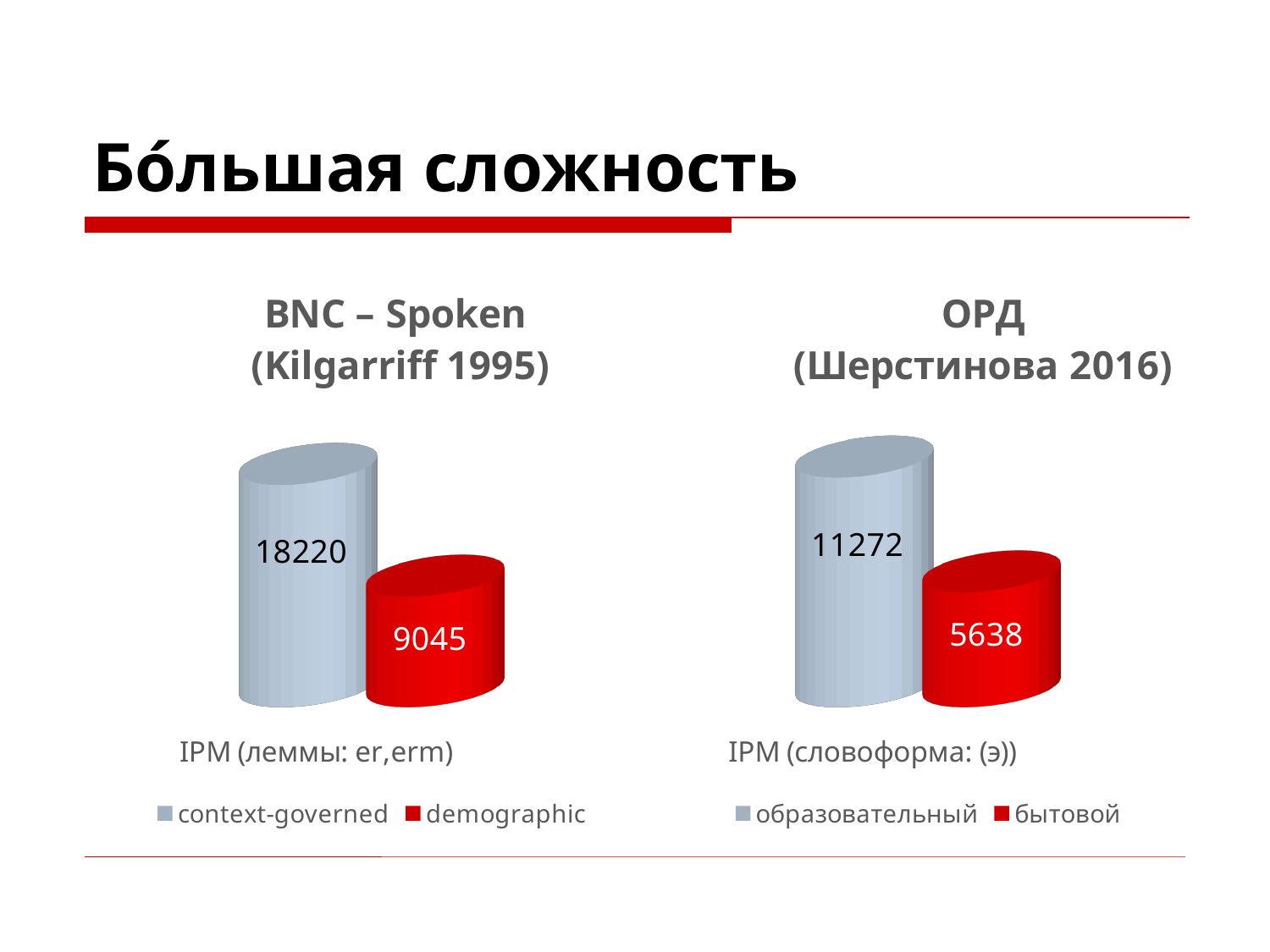
What is the category label shown under the bars of the ОРД (Шерстинова 2016) chart? IPM (словоформа: (э)) In the BNC – Spoken (Kilgarriff 1995) chart, what is the difference between the context-governed and demographic values? 9175 In the ОРД (Шерстинова 2016) chart, what is the difference between the образовательный and бытовой values? 5634 In the ОРД (Шерстинова 2016) chart, which series has the lower value? бытовой In the ОРД (Шерстинова 2016) chart, what is the value for образовательный? 11272 In the BNC – Spoken (Kilgarriff 1995) chart, what is the value for demographic? 9045 In the BNC – Spoken (Kilgarriff 1995) chart, what is the value for context-governed? 18220 What kind of chart is the BNC – Spoken (Kilgarriff 1995) chart? bar chart How many series does the legend of the ОРД (Шерстинова 2016) chart list? 2 In the BNC – Spoken (Kilgarriff 1995) chart, which series has the higher value? context-governed Is the context-governed value in the BNC – Spoken chart larger or smaller than the образовательный value in the ОРД chart? larger In the ОРД (Шерстинова 2016) chart, what is the value for бытовой? 5638